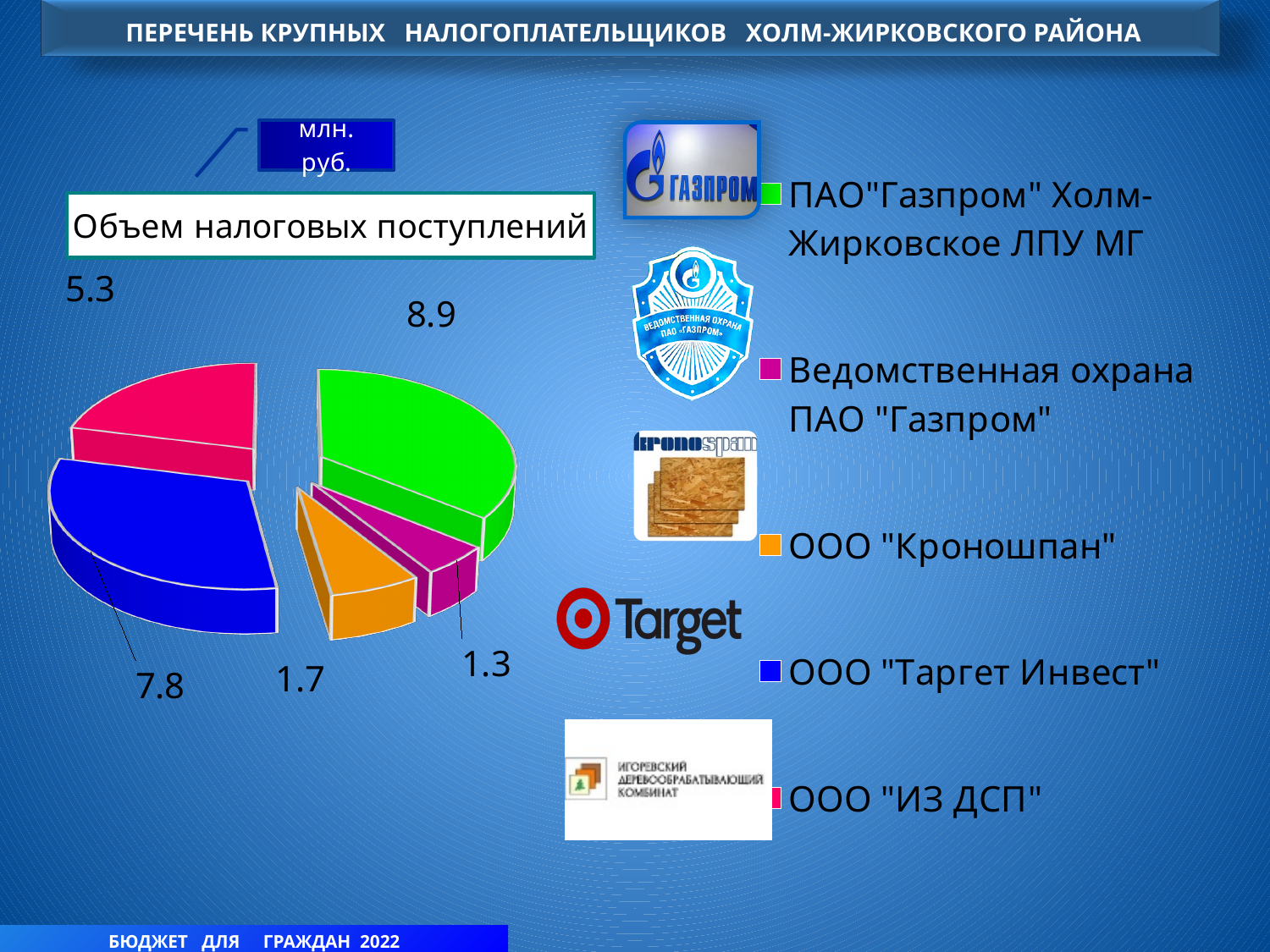
What is the value for Ведомственная охрана ПАО "Газпром" in the pie chart? 1.3 Which is larger: the value for ООО "Кроношпан" or the value for Ведомственная охрана ПАО "Газпром"? ООО "Кроношпан" Which taxpayer has the smallest slice in the pie chart? Ведомственная охрана ПАО "Газпром" What is the difference between the values for ПАО "Газпром" Холм-Жирковское ЛПУ МГ and ООО "Таргет Инвест"? 1.1 What is the value for ООО "Таргет Инвест" in the pie chart? 7.8 How many slices does the pie chart have? 5 What kind of chart is shown on the slide? pie chart What is the value for ООО "Кроношпан" in the pie chart? 1.7 What is the value for ПАО "Газпром" Холм-Жирковское ЛПУ МГ in the pie chart? 8.9 What is the value for ООО "ИЗ ДСП" in the pie chart? 5.3 Which taxpayer has the largest slice in the pie chart? ПАО "Газпром" Холм-Жирковское ЛПУ МГ What unit is indicated for the values in the pie chart? млн. руб.